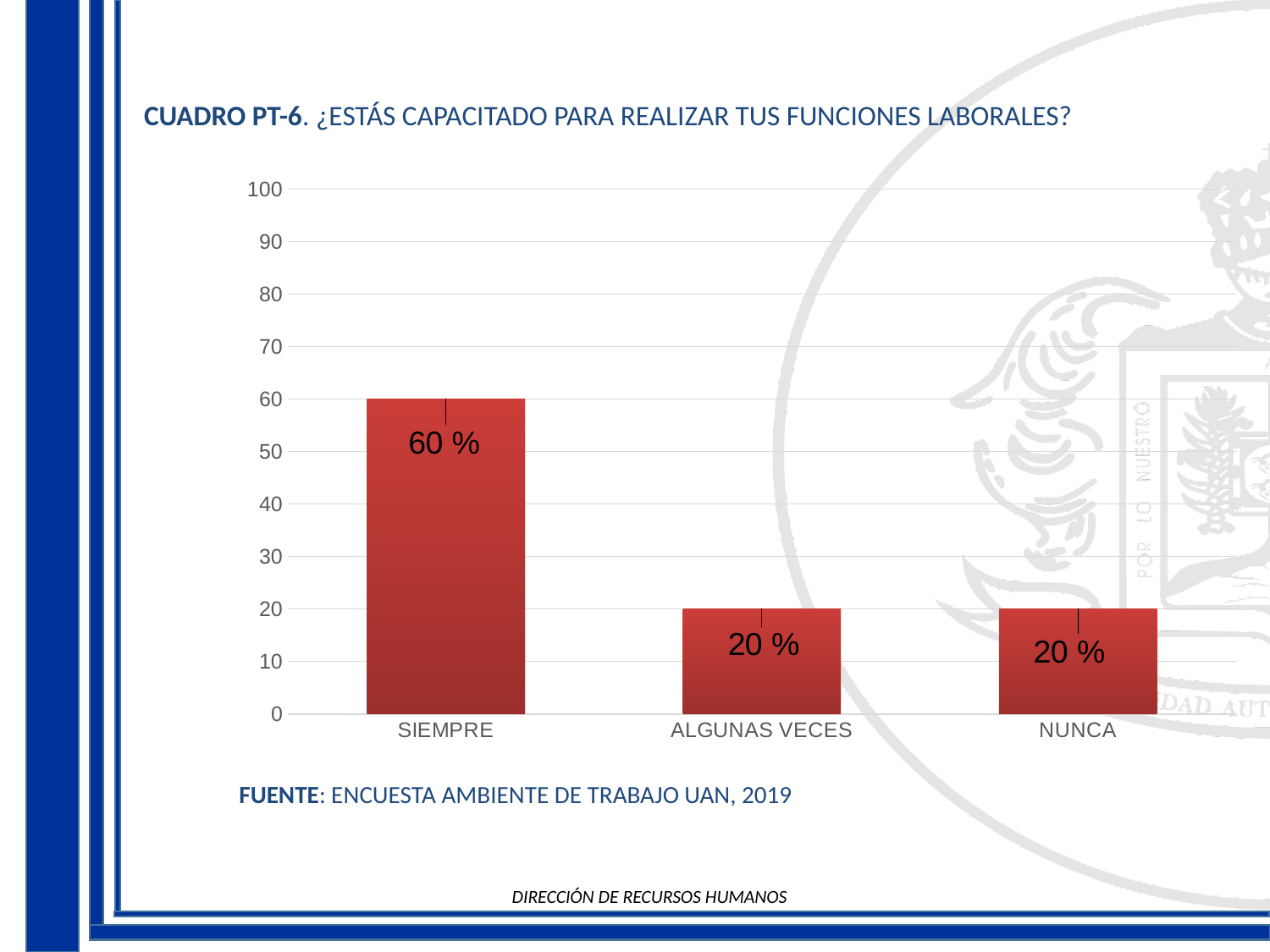
What kind of chart is shown on the slide? bar chart Is the value for SIEMPRE greater or less than 50? greater How many categories are shown on the x axis? 3 Which is larger, the value for SIEMPRE or the value for NUNCA? SIEMPRE Which category has the highest value? SIEMPRE What is the value for ALGUNAS VECES? 20 % What is the source cited below the chart? ENCUESTA AMBIENTE DE TRABAJO UAN, 2019 What is the total of the values for ALGUNAS VECES and NUNCA? 40 % Is the value for NUNCA greater or less than 30? less What is the value for NUNCA? 20 % What is the difference between the values for SIEMPRE and ALGUNAS VECES? 40 % What is the value for SIEMPRE? 60 %